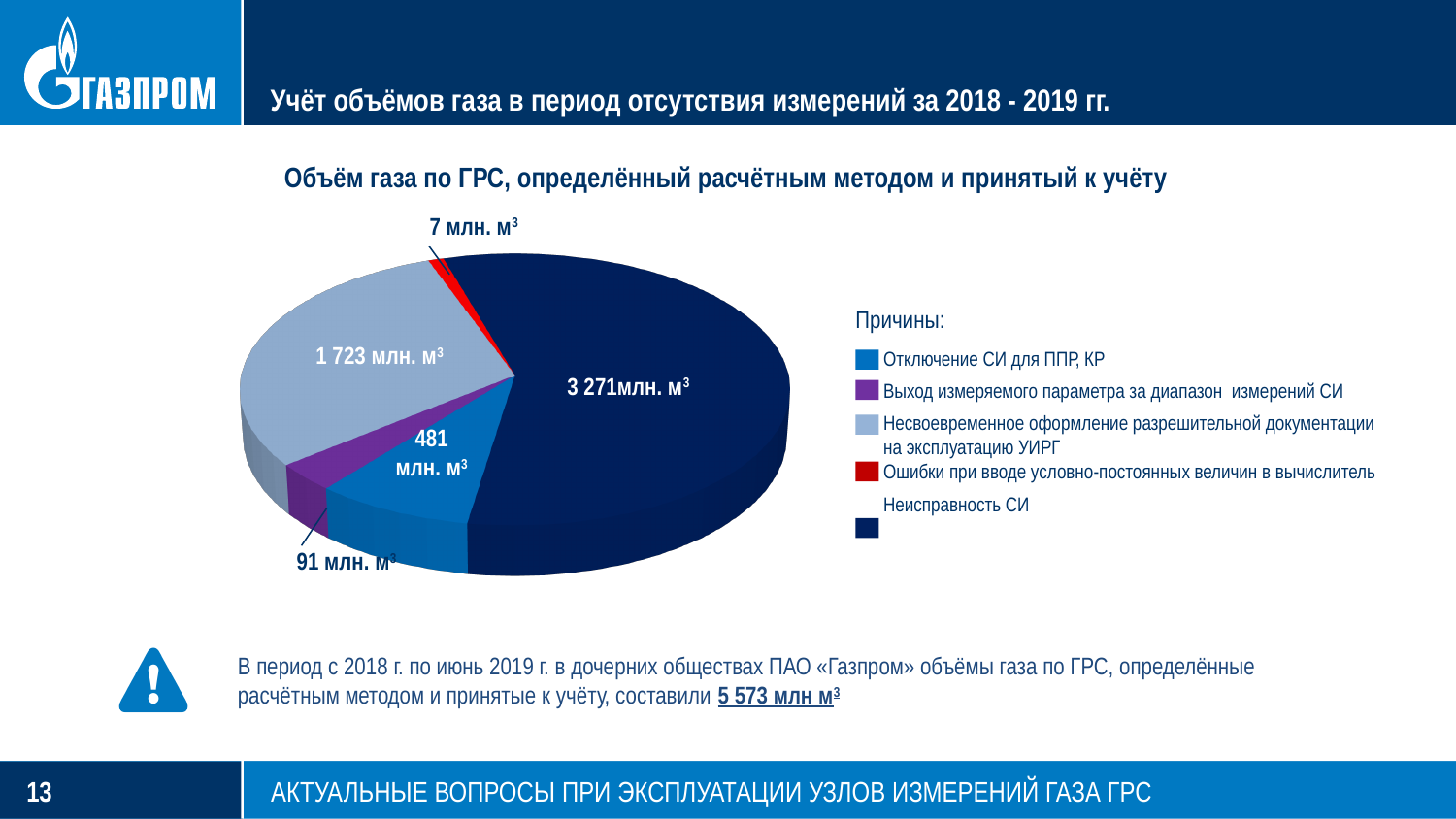
What is the value of the slice for 'Несвоевременное оформление разрешительной документации на эксплуатацию УИРГ' (light blue)? 1 723 млн. м³ How many slices does the pie chart have? 5 What is the value of the smallest slice of the pie chart? 7 млн. м³ What is the value of the purple slice ('Выход измеряемого параметра за диапазон измерений СИ')? 91 млн. м³ Which is larger: the slice for 'Неисправность СИ' or the slice for 'Несвоевременное оформление разрешительной документации на эксплуатацию УИРГ'? Неисправность СИ What is the total of all slices in the pie chart, as stated on the slide? 5 573 млн м³ What is the difference between the 3 271 млн. м³ slice and the 1 723 млн. м³ slice? 1 548 млн. м³ What type of chart is shown on the slide? Pie chart What is the title of the pie chart? Объём газа по ГРС, определённый расчётным методом и принятый к учёту How many causes (причины) are listed in the legend of the pie chart? 5 What is the value of the largest slice of the pie chart? 3 271 млн. м³ What is the value of the slice for 'Отключение СИ для ППР, КР' (blue)? 481 млн. м³